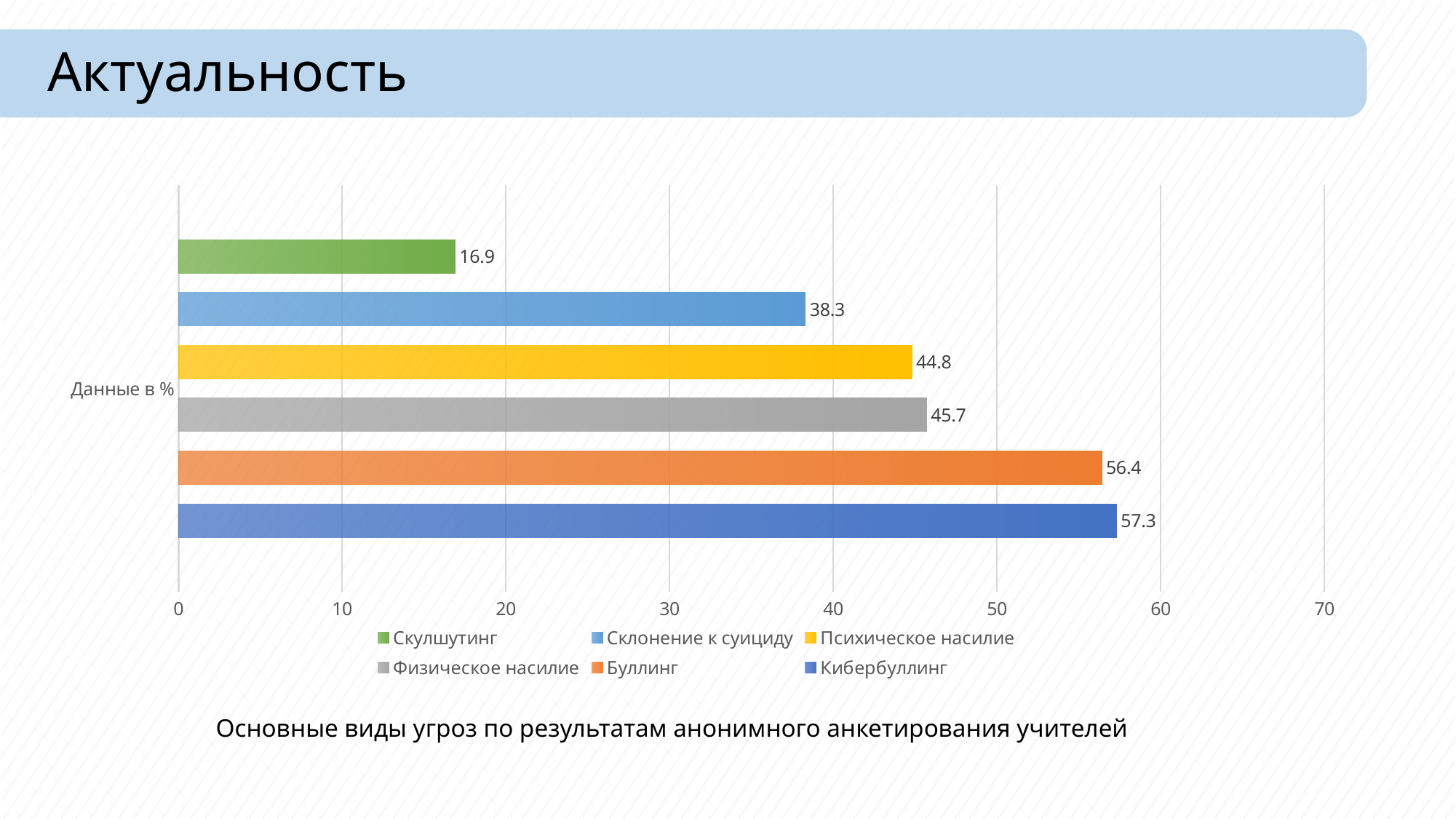
What colour is the bar for Буллинг? Orange Which series has the highest value? Кибербуллинг What value is shown for Скулшутинг? 16.9 What kind of chart is shown on the slide? Bar chart Which is larger, the value for Склонение к суициду or the value for Психическое насилие? Психическое насилие Which series has the lowest value? Скулшутинг How many series does the legend list? 6 What is the difference between the values for Буллинг and Скулшутинг? 39.5 What is the difference between the values for Физическое насилие and Психическое насилие? 0.9 What value is shown for Психическое насилие? 44.8 What value is shown for Кибербуллинг? 57.3 What value is shown for Склонение к суициду? 38.3